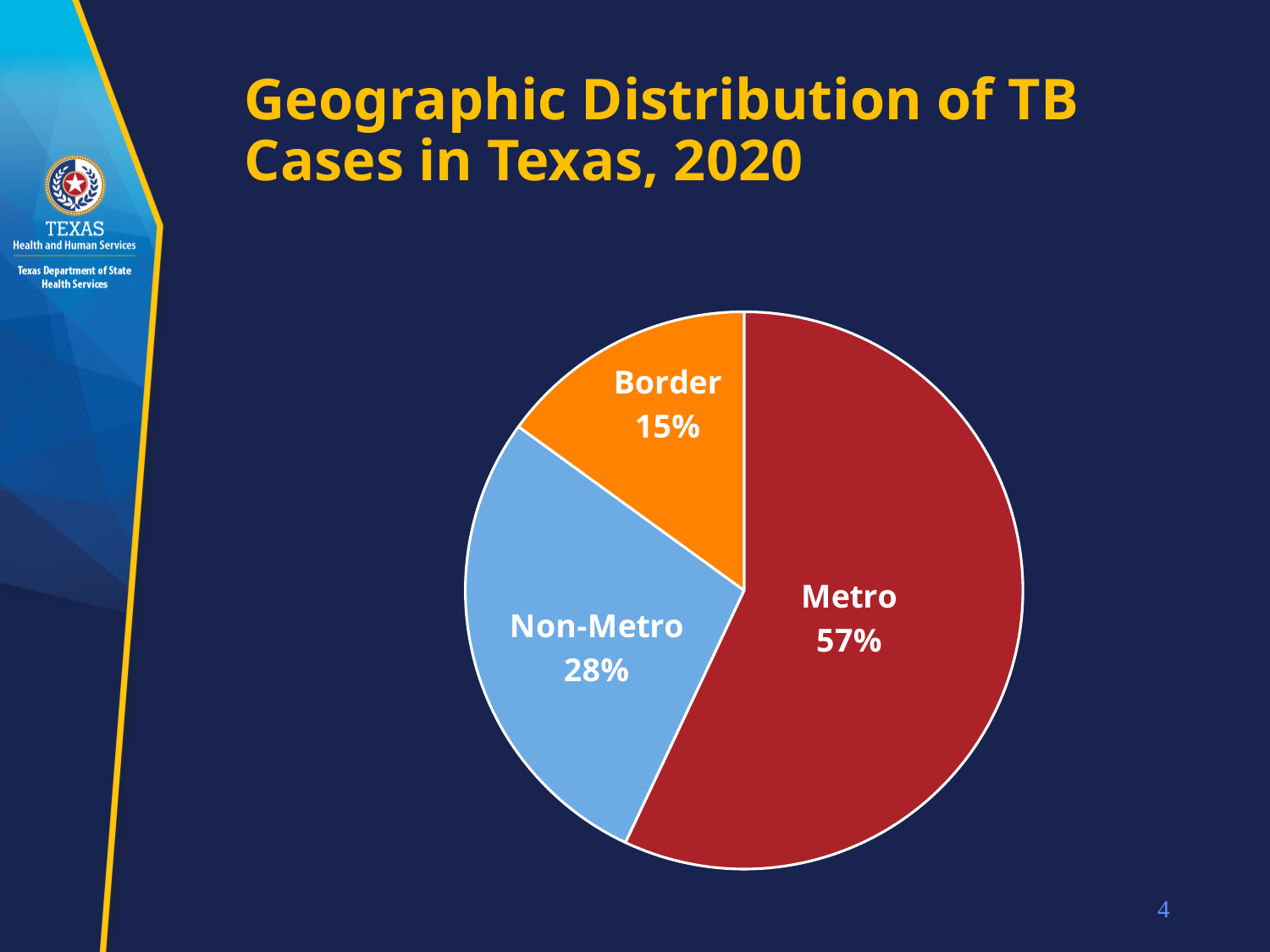
What kind of chart is shown on the slide? pie chart Which is larger, the Non-Metro share or the Border share? Non-Metro What colour is the Border slice of the pie chart? orange What share of TB cases were in Non-Metro areas? 28% Which geographic category has the smallest share of TB cases? Border How many slices does the pie chart have? 3 What is the difference in percentage points between the Non-Metro and Border shares? 13 What share of TB cases were in Border areas? 15% What is the difference in percentage points between the Metro and Non-Metro shares? 29 What is the title of the chart on the slide? Geographic Distribution of TB Cases in Texas, 2020 Which geographic category has the largest share of TB cases? Metro What share of TB cases in Texas in 2020 were in Metro areas? 57%